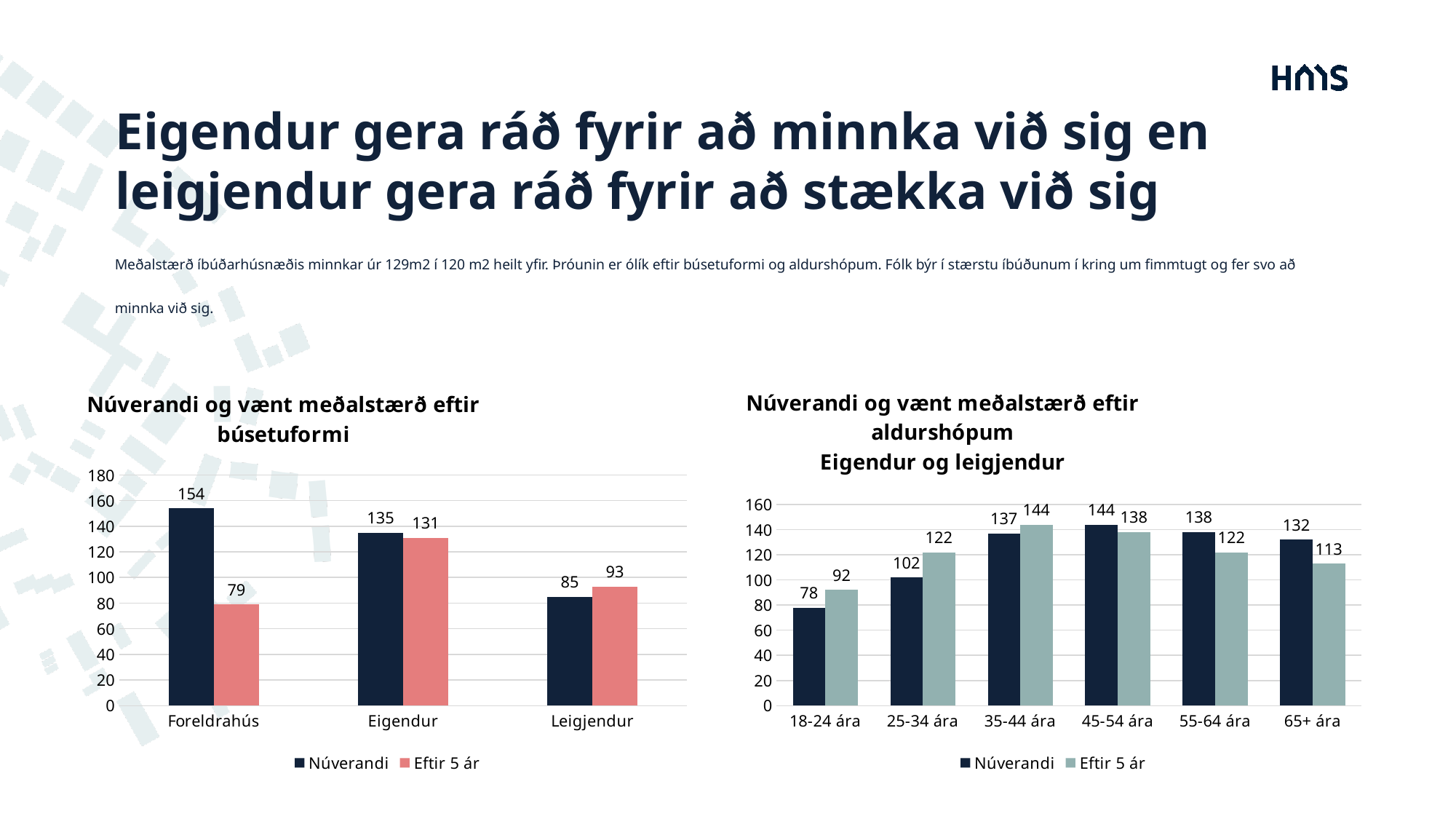
In the right chart 'Núverandi og vænt meðalstærð eftir aldurshópum', how many series does the legend list? 2 In the left chart 'Núverandi og vænt meðalstærð eftir búsetuformi', what is the difference between the Núverandi and Eftir 5 ár values for Foreldrahús? 75 In the left chart 'Núverandi og vænt meðalstærð eftir búsetuformi', how many categories are shown on the x axis? 3 In the right chart 'Núverandi og vænt meðalstærð eftir aldurshópum', what is the Eftir 5 ár value for 25-34 ára? 122 In the right chart 'Núverandi og vænt meðalstærð eftir aldurshópum', which age group has the highest Núverandi value? 45-54 ára In the right chart 'Núverandi og vænt meðalstærð eftir aldurshópum', how many age groups are shown? 6 In the left chart 'Núverandi og vænt meðalstærð eftir búsetuformi', which category has the lowest Núverandi value? Leigjendur In the left chart 'Núverandi og vænt meðalstærð eftir búsetuformi', what is the Núverandi value for Foreldrahús? 154 In the right chart 'Núverandi og vænt meðalstærð eftir aldurshópum', what is the difference between the Eftir 5 ár and Núverandi values for 18-24 ára? 14 In the left chart 'Núverandi og vænt meðalstærð eftir búsetuformi', what is the Eftir 5 ár value for Leigjendur? 93 In the right chart 'Núverandi og vænt meðalstærð eftir aldurshópum', which is larger for 65+ ára: the Núverandi value or the Eftir 5 ár value? Núverandi What type of chart is the left chart 'Núverandi og vænt meðalstærð eftir búsetuformi'? Bar chart